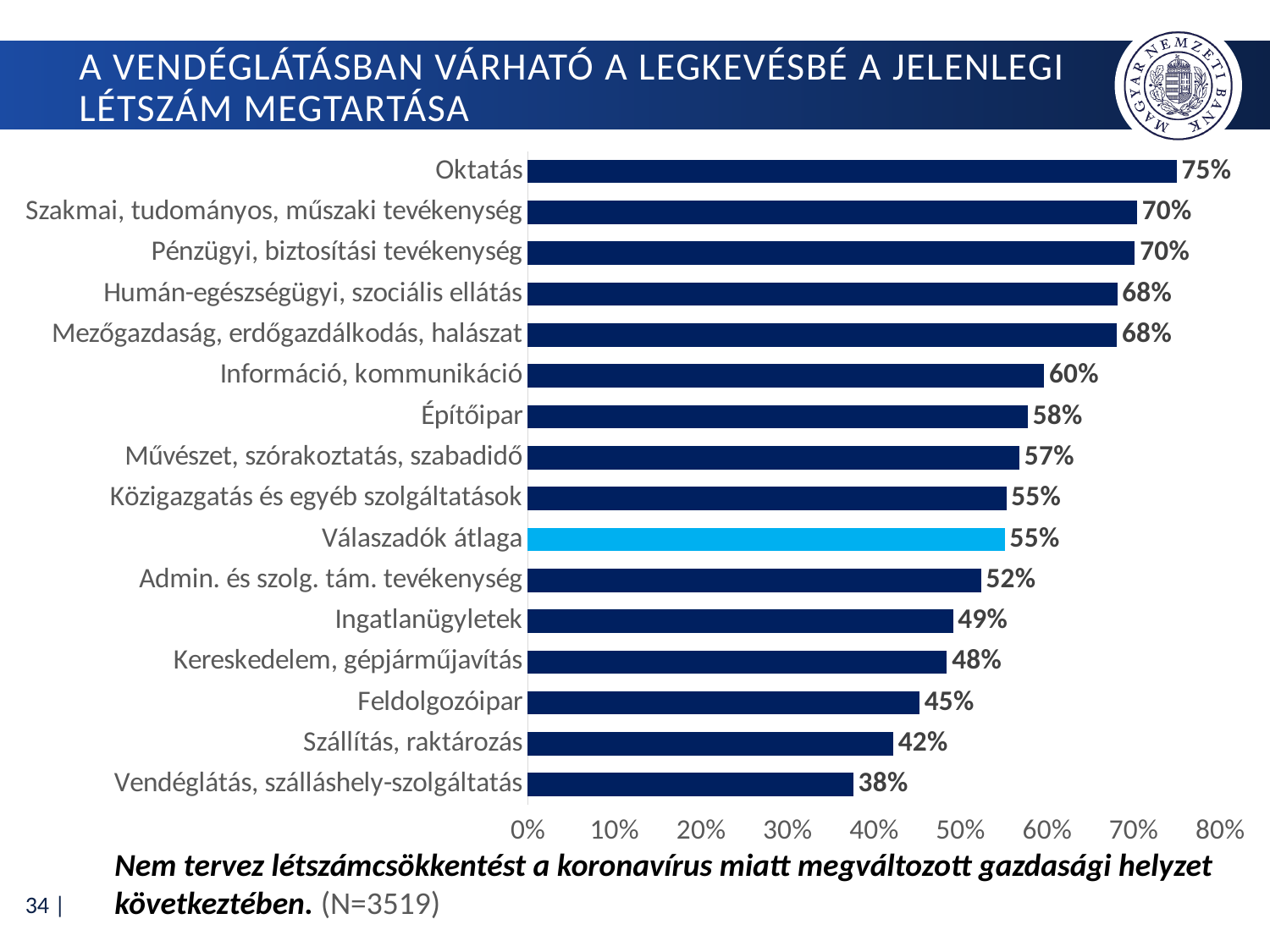
What is the value for Vendéglátás, szálláshely-szolgáltatás? 38% Is the value for Információ, kommunikáció greater or less than 50%? greater What is the value for Oktatás? 75% Which category has the lowest value? Vendéglátás, szálláshely-szolgáltatás Which category's bar is shown in a lighter blue colour than the others? Válaszadók átlaga What is the value for Válaszadók átlaga? 55% Which is larger, the value for Építőipar or the value for Ingatlanügyletek? Építőipar What kind of chart is shown on the slide? bar chart Which category has the highest value? Oktatás What is the difference between the values for Oktatás and Vendéglátás, szálláshely-szolgáltatás? 37% How many categories are shown in the chart? 16 What is the value for Feldolgozóipar? 45%